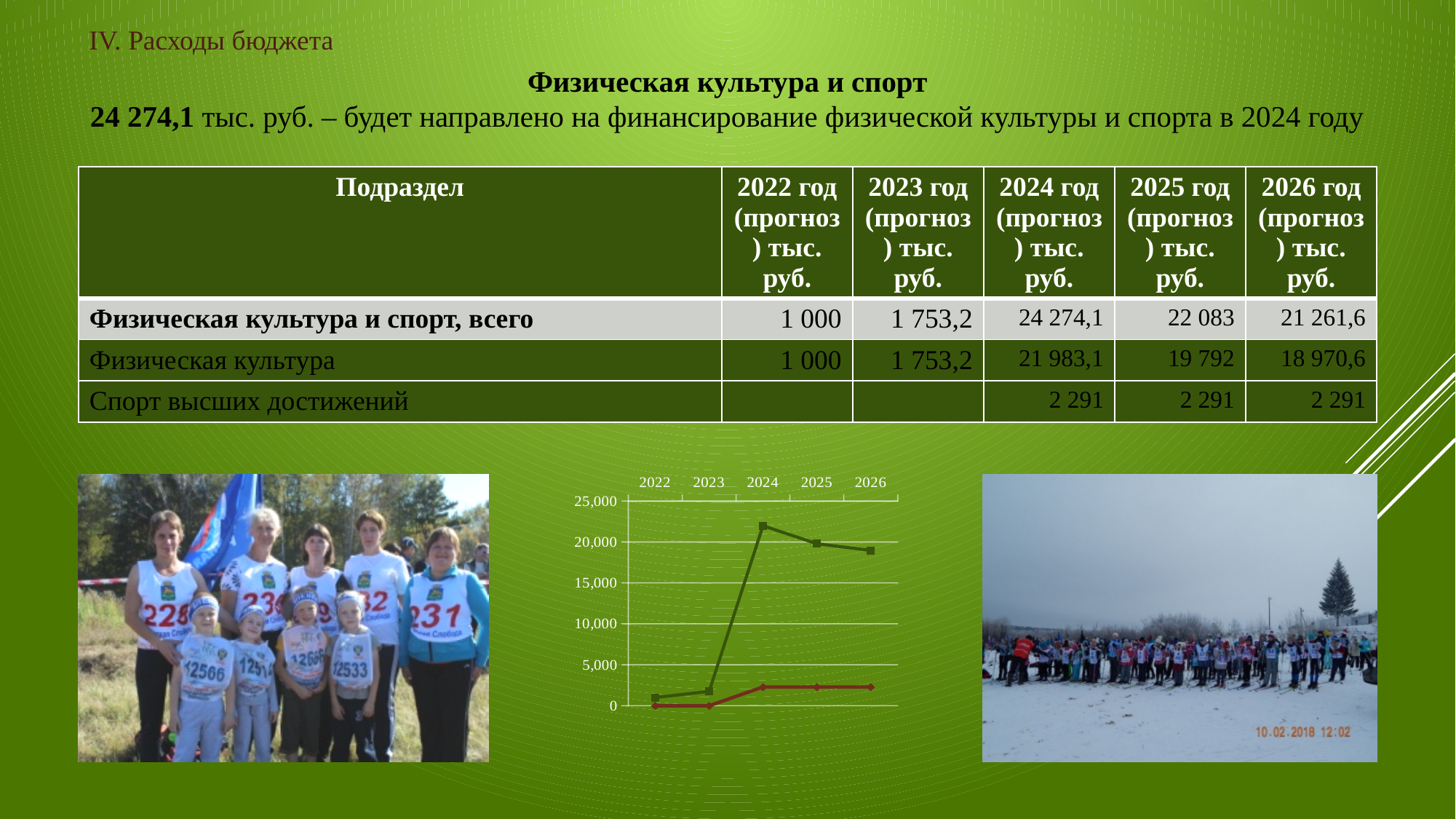
On the line chart, does the dark green line rise or fall from 2024 to 2026? fall On the line chart, is the value of the dark green line for 2023 greater or less than 5,000? less What kind of chart is shown at the bottom centre of the slide? line chart What is the highest value labelled on the y axis of the line chart? 25,000 On the line chart, is the value of the dark red line for 2025 greater or less than 5,000? less On the line chart, in which year does the dark green line reach its highest point? 2024 On the line chart, is the value of the dark green line for 2026 greater or less than 20,000? less How many years are shown along the x axis of the line chart? 5 How many lines are plotted on the line chart? 2 On the line chart, in 2024 which line is higher, the dark green line or the dark red line? the dark green line What is the first year shown on the x axis of the line chart? 2022